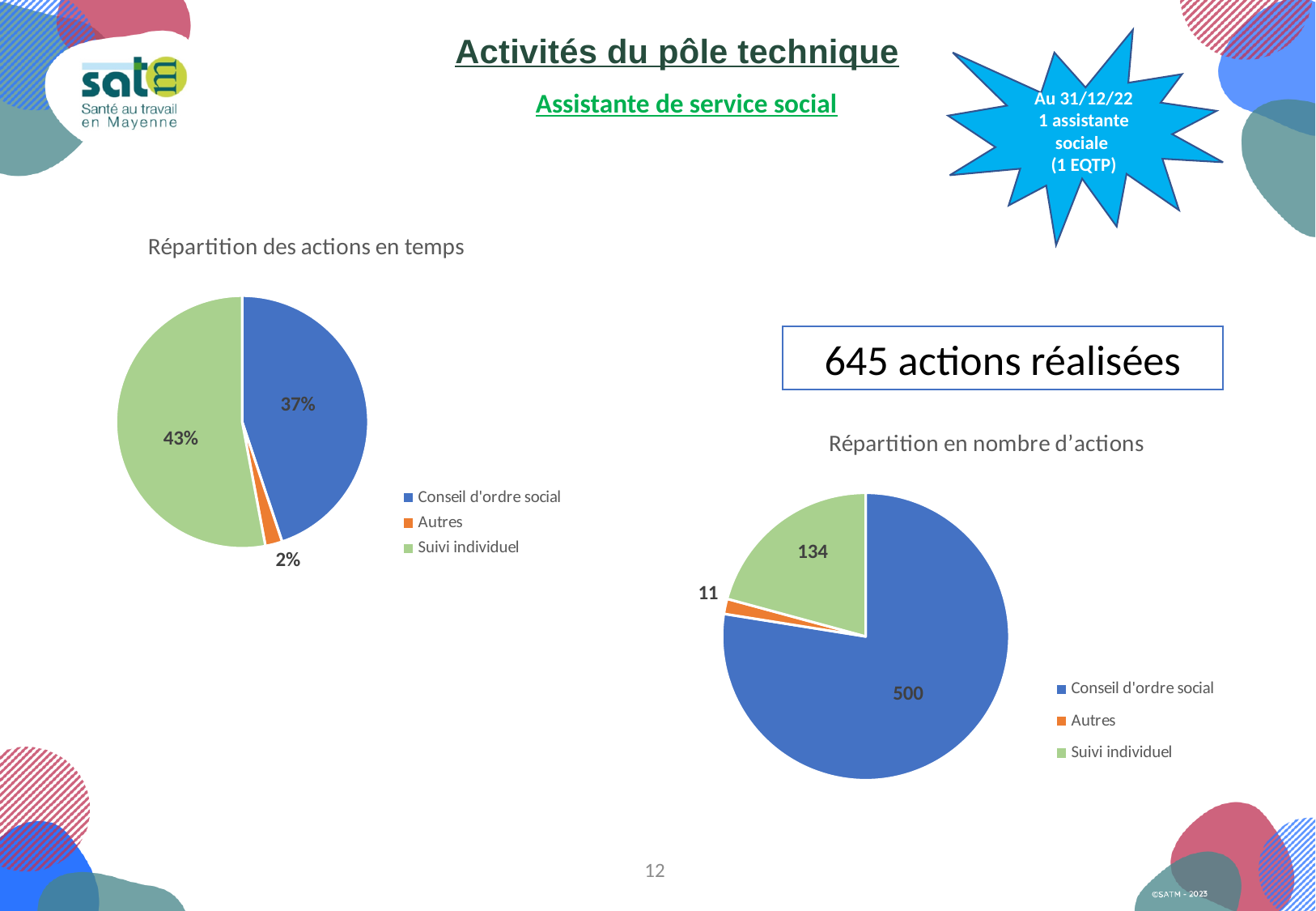
What type of chart is 'Répartition des actions en temps'? pie chart In the 'Répartition des actions en temps' chart, how many categories does the legend list? 3 In the 'Répartition en nombre d'actions' chart, what colour is the Autres slice? orange In the 'Répartition en nombre d'actions' chart, how many actions are shown for Autres? 11 In the 'Répartition en nombre d'actions' chart, how many actions are shown for Suivi individuel? 134 In the 'Répartition des actions en temps' chart, what percentage is shown for Conseil d'ordre social? 37% In the 'Répartition en nombre d'actions' chart, which category has the largest slice? Conseil d'ordre social In the 'Répartition des actions en temps' chart, what percentage is shown for Suivi individuel? 43% In the 'Répartition des actions en temps' chart, which category has the smallest slice? Autres In the 'Répartition en nombre d'actions' chart, how many actions are shown for Conseil d'ordre social? 500 In the 'Répartition des actions en temps' chart, what percentage is shown for Autres? 2% In the 'Répartition en nombre d'actions' chart, what is the difference between the values for Conseil d'ordre social and Suivi individuel? 366